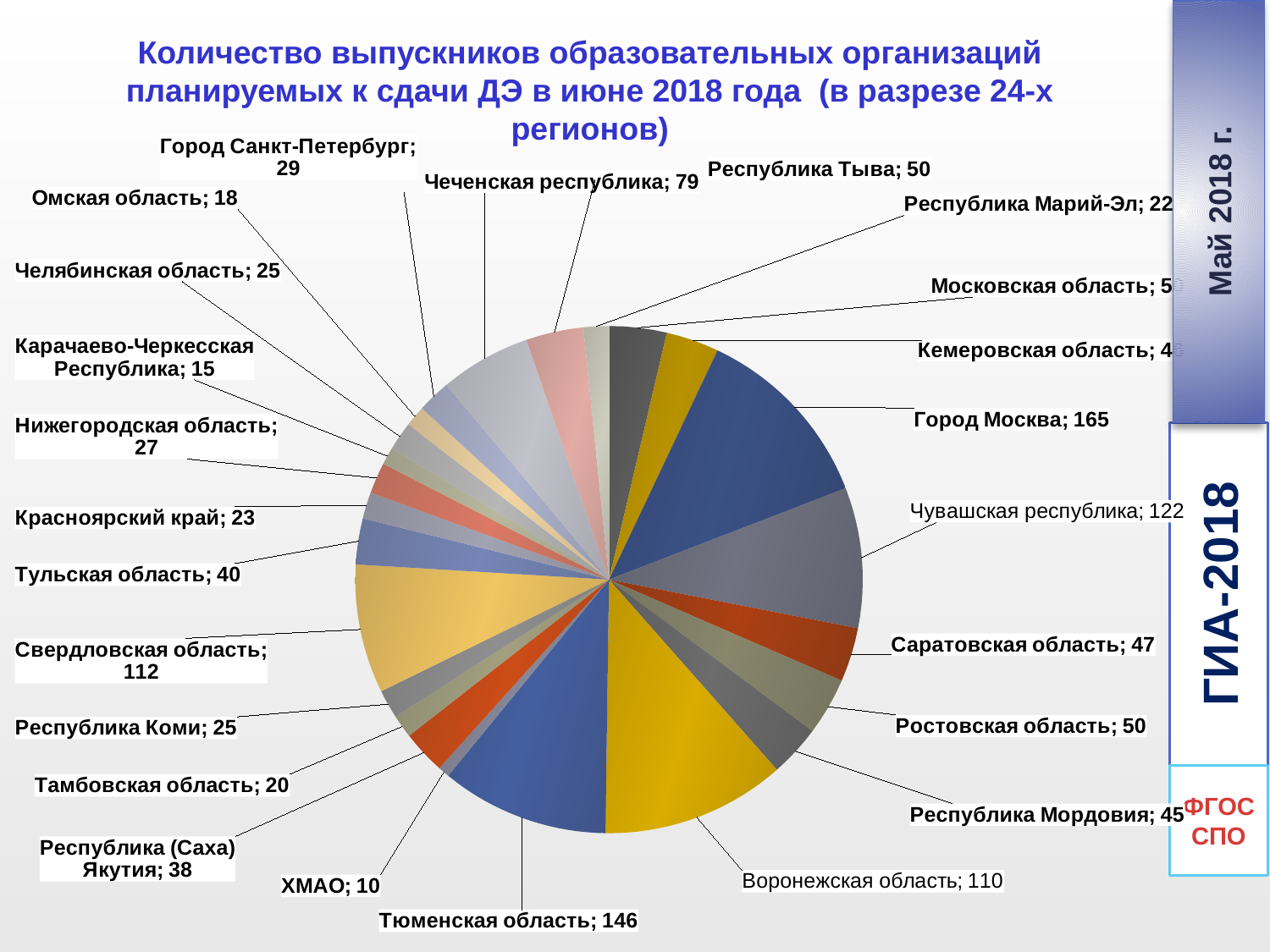
What is the difference between the values for Город Москва and Чувашская республика? 43 According to the chart title, in which month and year is the ДЭ planned to be taken? June 2018 (июнь 2018 года) Which region has the highest value in the pie chart? Город Москва What is the value for Свердловская область? 112 What is the value for Чеченская республика? 79 What is the value for Тюменская область? 146 What is the value for ХМАО? 10 What is the value for Город Москва? 165 What is the difference between the values for Тюменская область and Воронежская область? 36 Which is larger, the value for Саратовская область or the value for Ростовская область? Ростовская область How many regions (slices) are shown in the pie chart? 24 What type of chart is shown on the slide? Pie chart